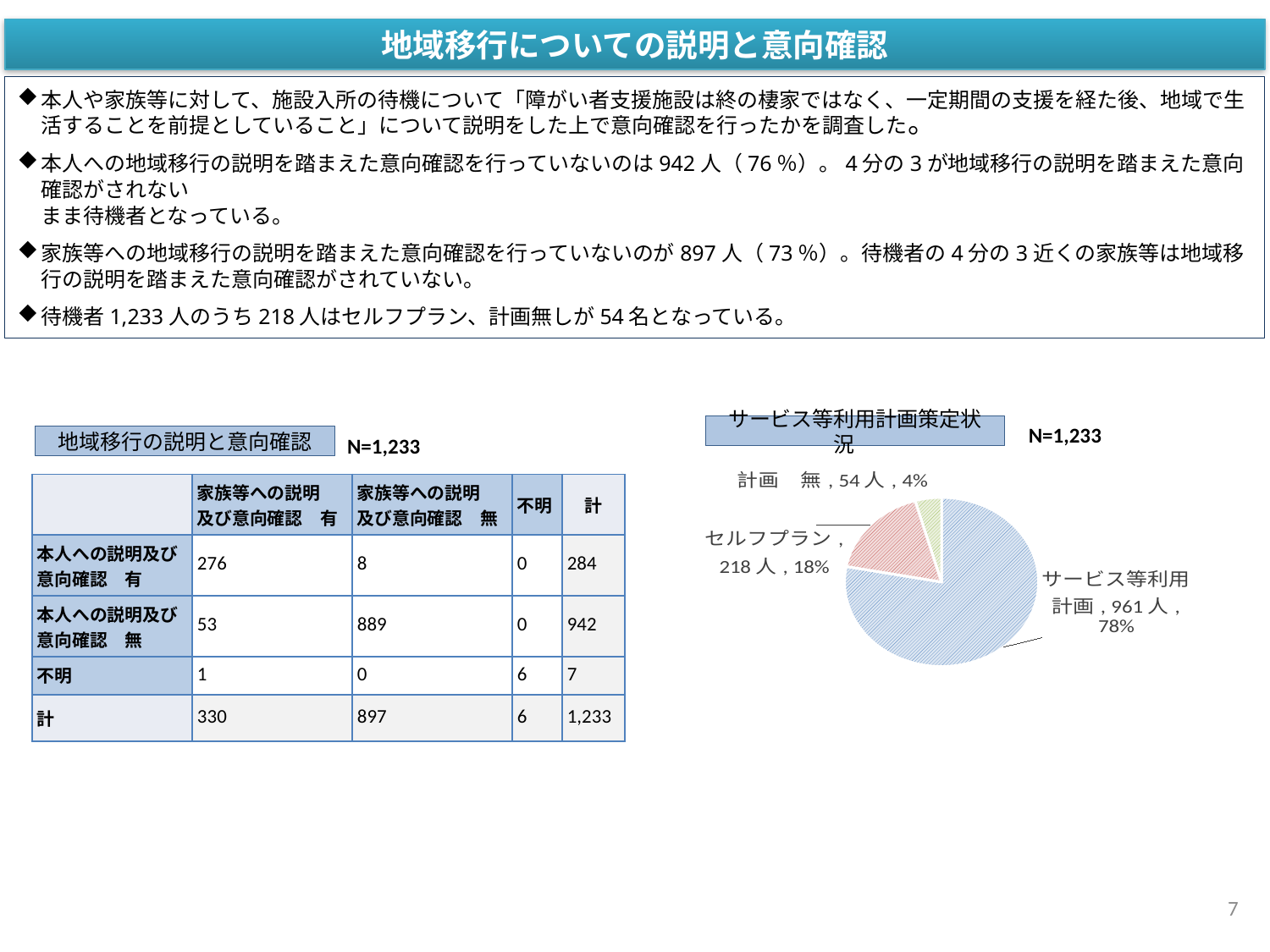
Which is larger in the pie chart, セルフプラン or 計画無? セルフプラン What kind of chart is shown on the slide? pie chart What is the difference in number of people between the セルフプラン slice and the 計画無 slice? 164人 How many people are in the サービス等利用計画 slice of the pie chart? 961人 What is the title of the pie chart? サービス等利用計画策定状況 What share of the pie does セルフプラン represent? 18% Which slice of the pie chart is the largest? サービス等利用計画 How many slices does the pie chart have? 3 What share of the pie does サービス等利用計画 represent? 78% What share of the pie does 計画無 represent? 4% How many people are in the セルフプラン slice of the pie chart? 218人 Which slice of the pie chart is the smallest? 計画無